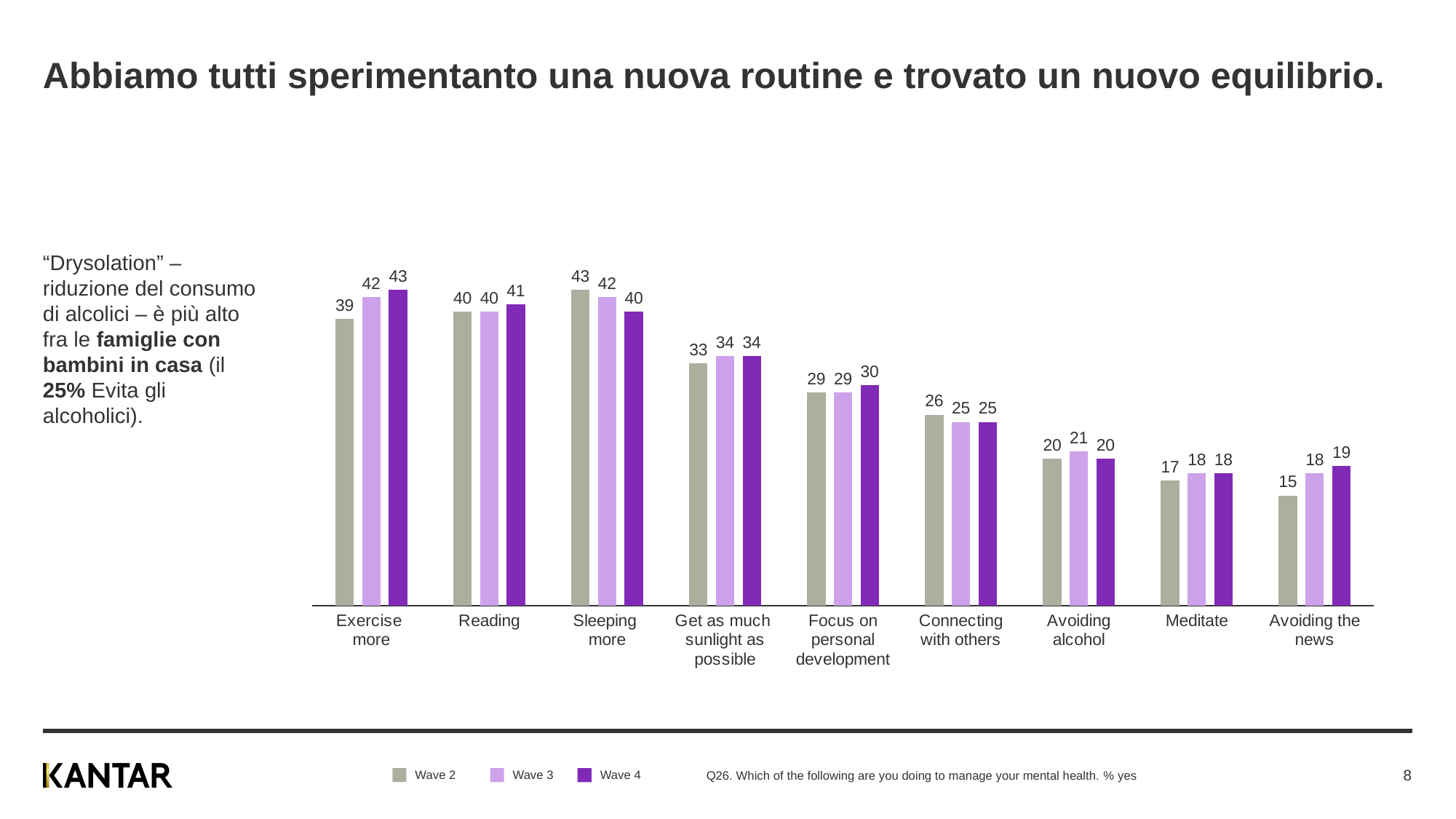
How many series does the legend list? 3 What kind of chart is shown on the slide? Bar chart Which category has the lowest Wave 4 value? Meditate How many categories are shown on the x axis? 9 Which is larger for Sleeping more: the Wave 2 value or the Wave 4 value? Wave 2 Do the Wave 2 values generally rise or fall from left to right along the x axis? Fall Which category has the highest Wave 2 value? Sleeping more What is the Wave 4 value for Exercise more? 43 What is the Wave 2 value for Avoiding the news? 15 What is the Wave 3 value for Get as much sunlight as possible? 34 What are the three series listed in the legend? Wave 2, Wave 3, Wave 4 What is the difference between the Wave 4 and Wave 2 values for Exercise more? 4